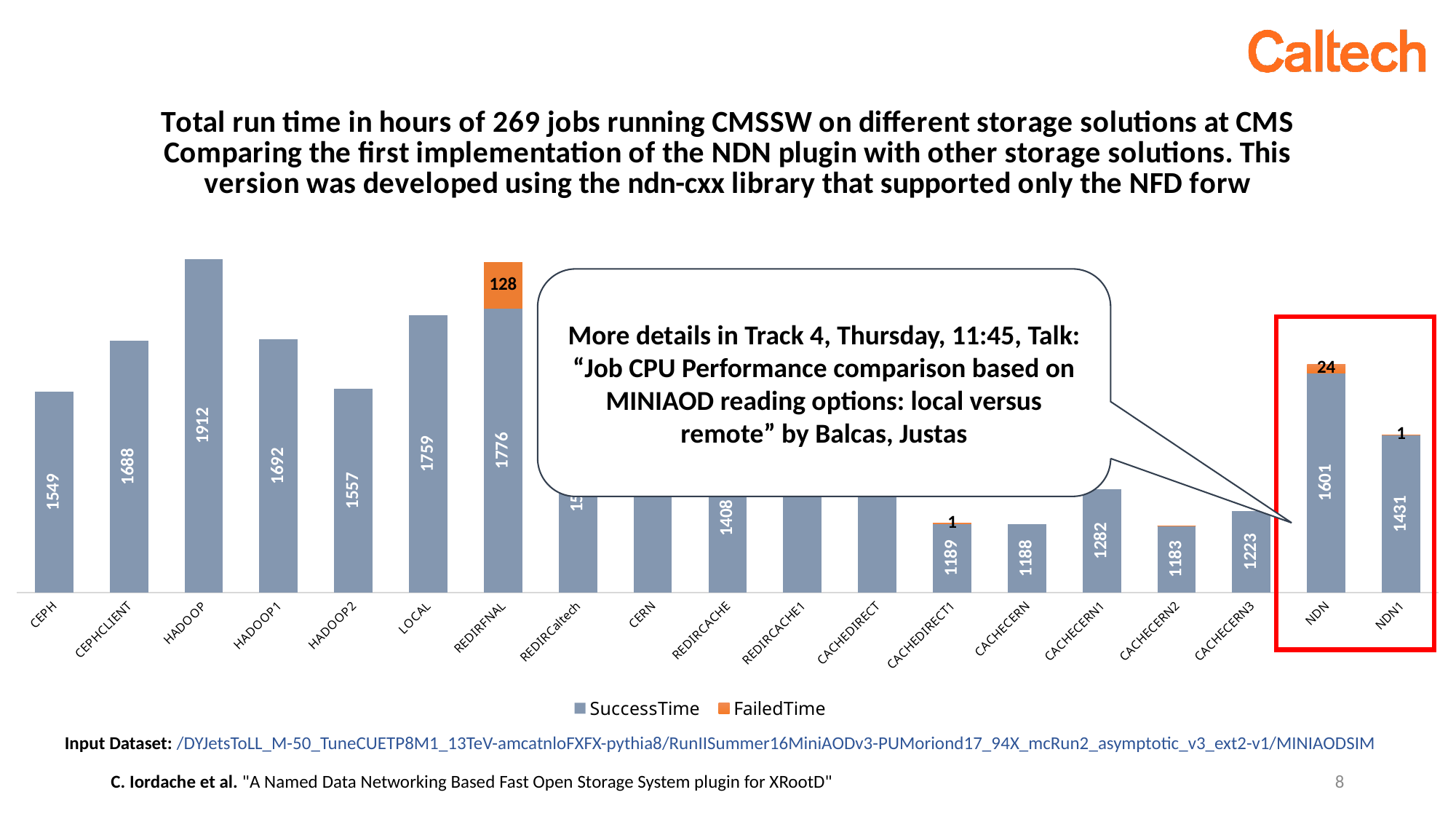
Which storage solution has the highest SuccessTime? HADOOP How many series does the legend list? 2 What is the total run time (SuccessTime plus FailedTime) for the REDIRFNAL bar? 1904 What is the total run time (SuccessTime plus FailedTime) for the NDN bar? 1625 What is the difference between the SuccessTime of HADOOP and CEPH? 363 What is the FailedTime value for NDN? 24 What is the difference between the SuccessTime of NDN and NDN1? 170 Which has a larger SuccessTime, LOCAL or HADOOP1? LOCAL What kind of chart is shown on the slide? Stacked bar chart What is the FailedTime value for REDIRFNAL? 128 What is the SuccessTime value for HADOOP? 1912 What is the SuccessTime value for NDN? 1601